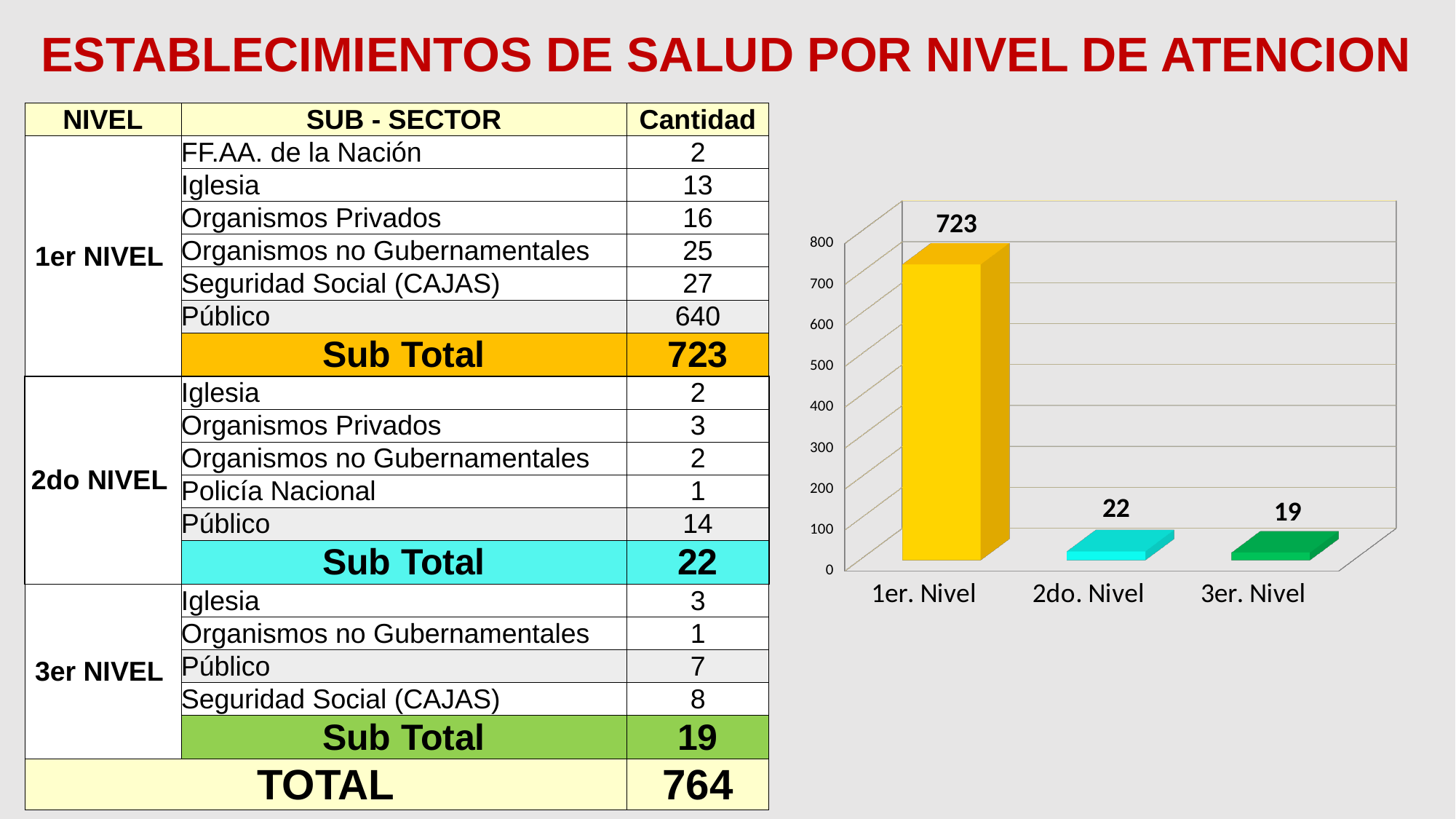
What is the value for 1er. Nivel in the chart? 723 What is the value for 2do. Nivel in the chart? 22 What kind of chart is shown on the slide? bar chart Which category has the highest value in the chart? 1er. Nivel What is the difference between the values for 2do. Nivel and 3er. Nivel? 3 Which category has the lowest value in the chart? 3er. Nivel What is the value for 3er. Nivel in the chart? 19 Which is larger, the value for 1er. Nivel or the value for 3er. Nivel? 1er. Nivel Is the value for 1er. Nivel greater or less than 700? greater What is the difference between the values for 1er. Nivel and 2do. Nivel? 701 How many categories are shown on the x axis of the chart? 3 Do the values rise or fall from 1er. Nivel to 3er. Nivel along the x axis? fall